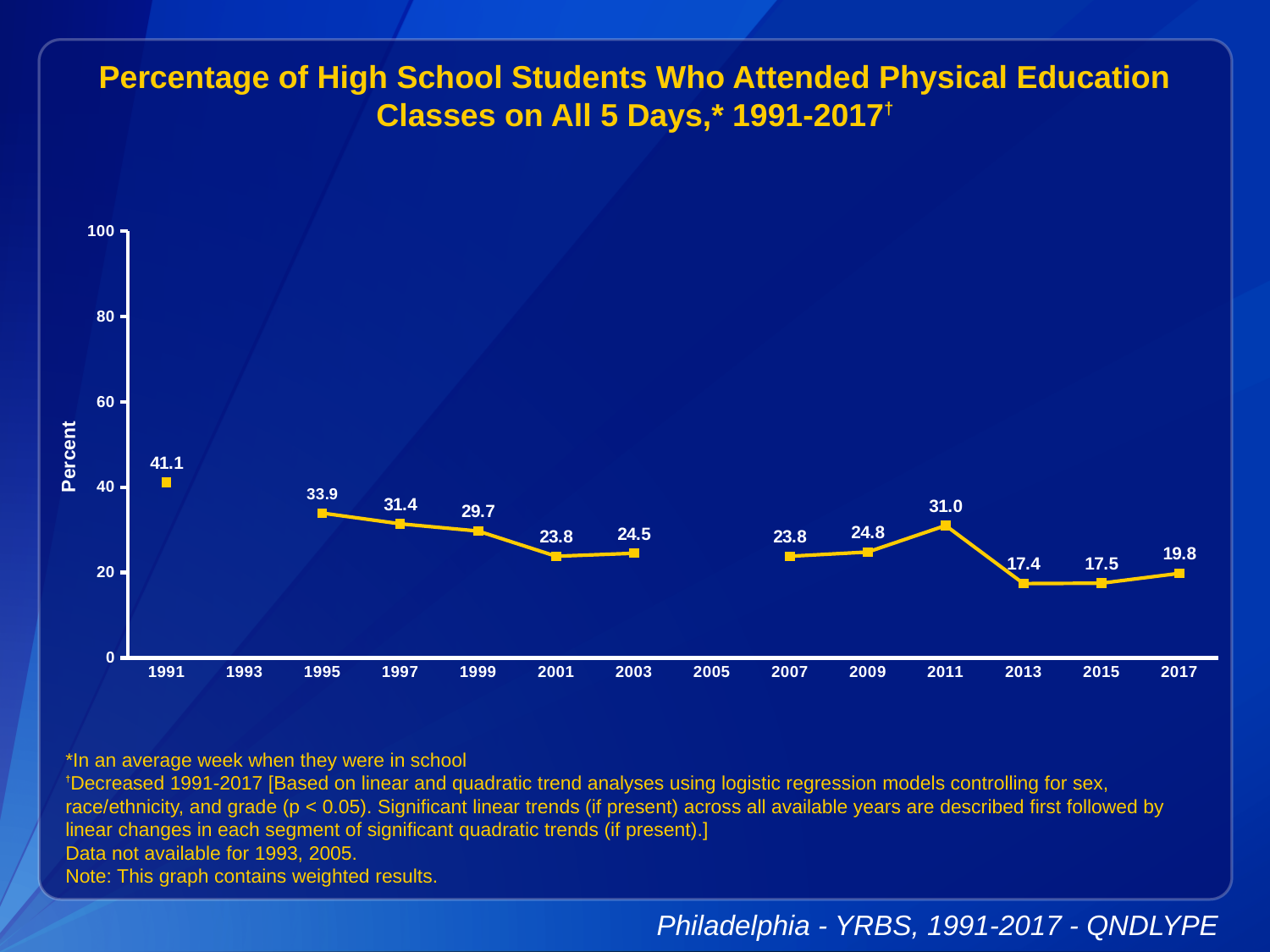
What is the value plotted for 2011? 31.0 What percentage of high school students attended physical education classes on all 5 days in 1991? 41.1 What is the label on the vertical axis? Percent How many years have data points plotted on the chart? 12 Is the value for 1995 greater or less than 40? less Which is larger, the value for 2009 or the value for 2011? 2011 Which year has the highest value on the chart? 1991 What is the difference between the 1991 value and the 2017 value? 21.3 What kind of chart is shown on the slide? line chart Which year has the lowest value on the chart? 2013 What is the value plotted for 2017? 19.8 Overall, do the values rise or fall from 1991 to 2017? fall